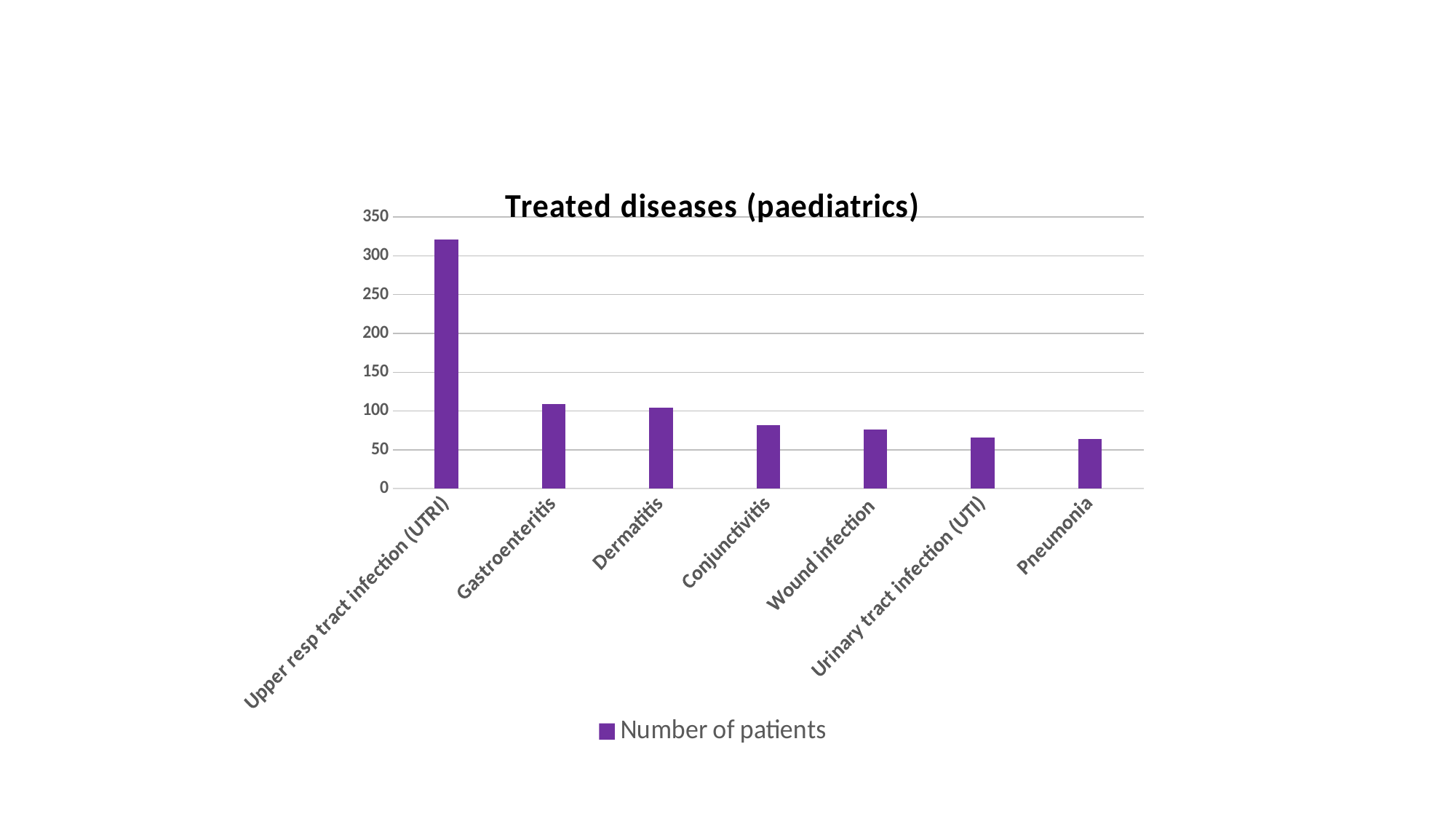
How many disease categories are plotted on the chart? 7 Is the value for Pneumonia greater or less than 50? greater Do the values rise or fall moving from left to right along the x axis? fall Is the value for Gastroenteritis greater or less than 150? less Is the value for Upper resp tract infection (UTRI) greater or less than 300? greater Which has more patients, Upper resp tract infection (UTRI) or Gastroenteritis? Upper resp tract infection (UTRI) How many series does the legend list? 1 What is the name of the series shown in the legend? Number of patients What kind of chart is shown on the slide? bar chart What is the title of the chart? Treated diseases (paediatrics) Which disease has the highest number of patients? Upper resp tract infection (UTRI)